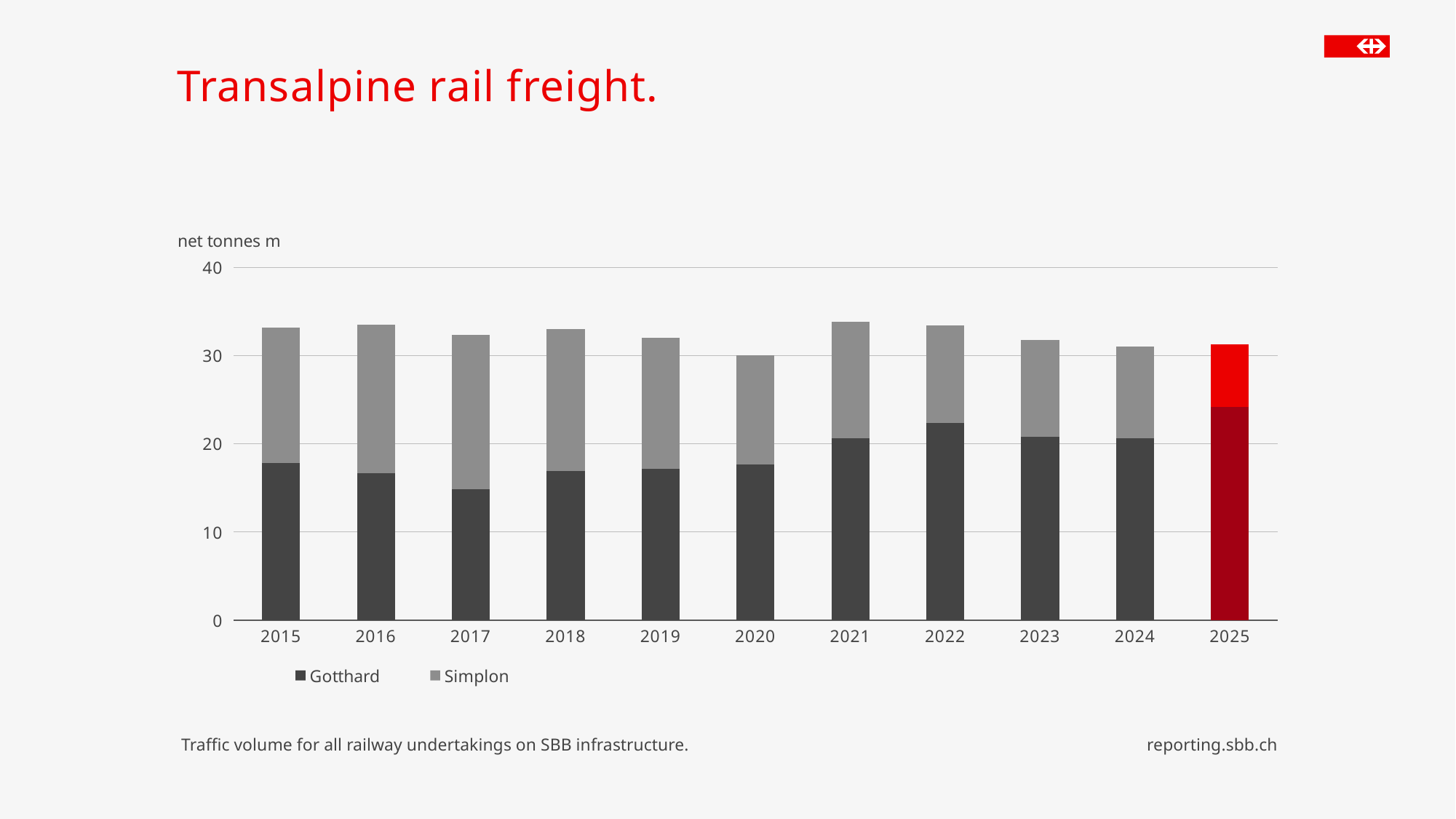
In which year is the Gotthard freight volume lowest? 2017 Which two series are listed in the chart legend? Gotthard and Simplon Is the total freight volume for 2021 greater or less than 30? greater How many series does the chart legend list? 2 Is the Gotthard value for 2025 greater or less than 20? greater Which year has the larger Gotthard freight volume, 2016 or 2022? 2022 How many years are shown on the x axis of the chart? 11 In which year is the total transalpine rail freight volume lowest? 2020 In which year is the Gotthard freight volume highest? 2025 What kind of chart is shown on the slide? Stacked bar chart Is the Gotthard value for 2017 greater or less than 20? less What unit is given for the y axis of the chart? net tonnes m